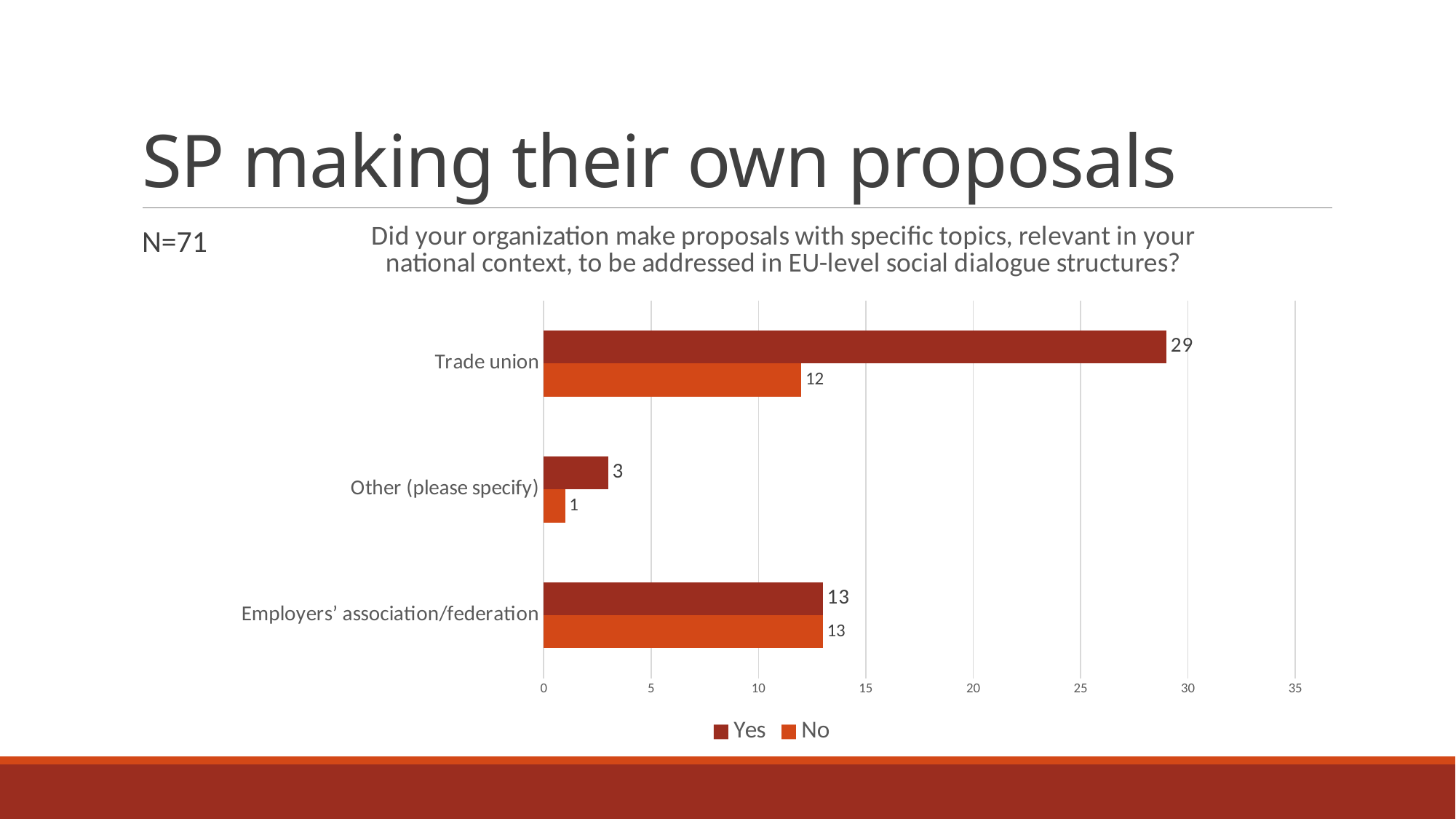
How many series does the legend list? 2 What is the 'Yes' value for Other (please specify)? 3 Which is larger for Other (please specify): the 'Yes' value or the 'No' value? Yes Which category has the lowest 'No' value? Other (please specify) What kind of chart is shown on the slide? Bar chart How many categories are shown on the chart? 3 What is the 'No' value for Employers' association/federation? 13 What is the 'Yes' value for Trade union? 29 What is the difference between the 'Yes' and 'No' values for Trade union? 17 Which category has the highest 'Yes' value? Trade union What is the 'No' value for Trade union? 12 What sample size (N) is stated on the slide? N=71